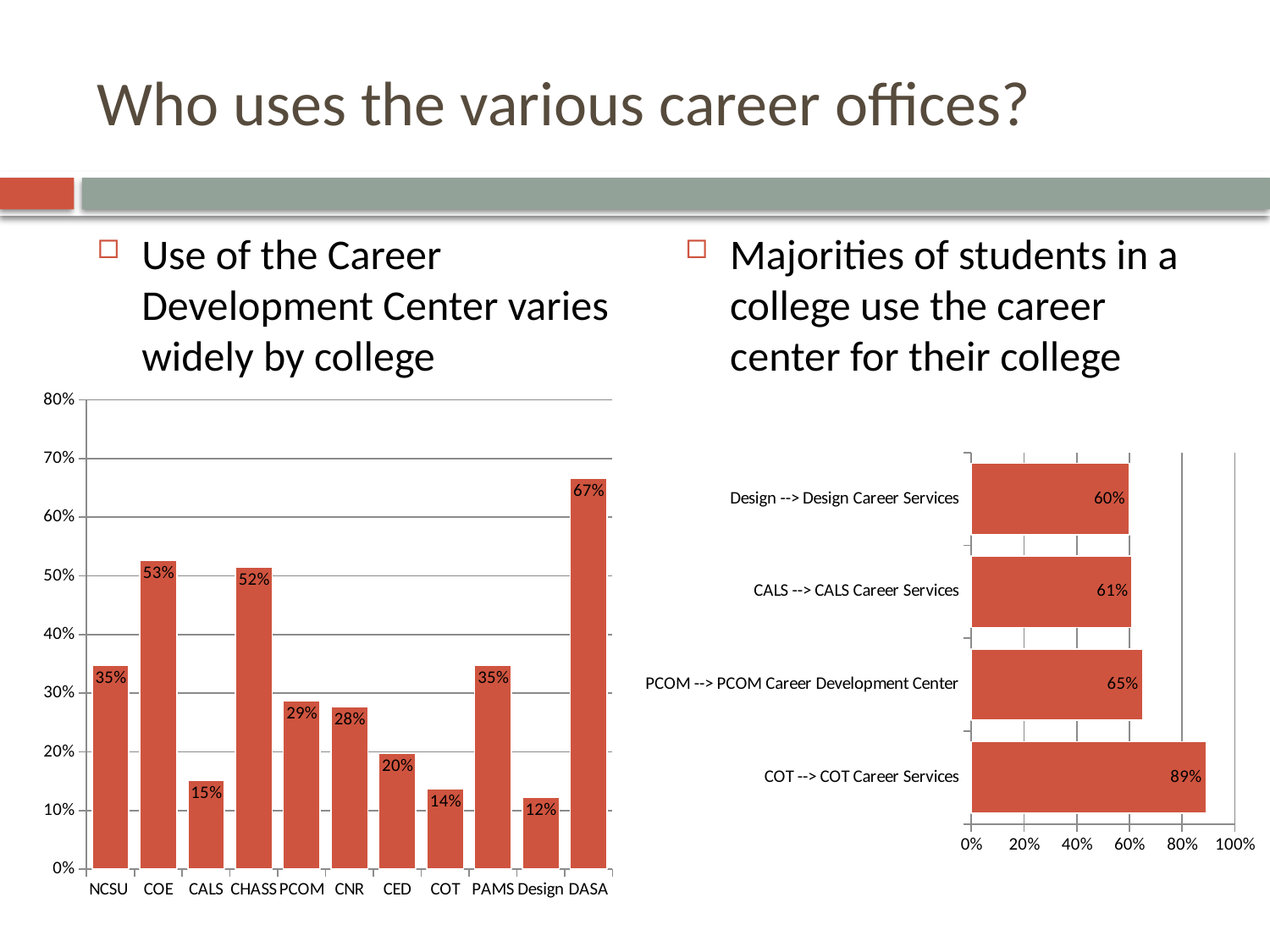
What kind of chart is the left chart? Bar chart In the left chart, which is larger, the value for CED or the value for COT? CED In the left chart, what is the difference between the values for COE and CALS? 38% How many categories are shown in the right chart? 4 In the left chart, what is the value for CHASS? 52% In the left chart, which college has the highest value? DASA In the right chart, what is the value for PCOM --> PCOM Career Development Center? 65% In the left chart, what is the value for DASA? 67% In the right chart, which category has the highest value? COT --> COT Career Services In the left chart, which college has the lowest value? Design How many colleges are shown on the x axis of the left chart? 11 In the right chart, what is the value for COT --> COT Career Services? 89%